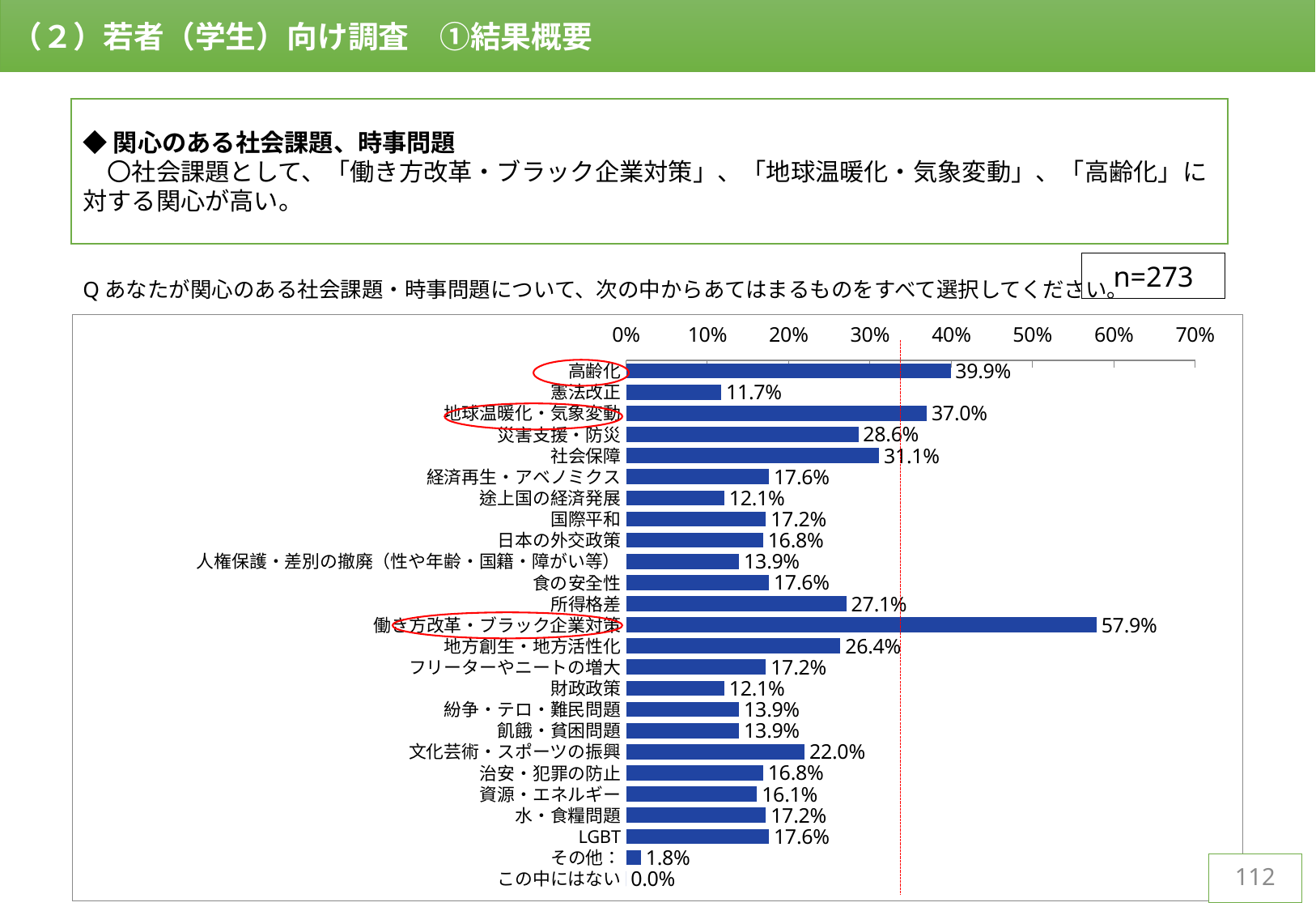
Is the value for 文化芸術・スポーツの振興 greater or less than 20%? greater What is the difference between the values for 働き方改革・ブラック企業対策 and 高齢化? 18.0% What is the value for 高齢化? 39.9% Which category has the lowest value? この中にはない Which is larger, the value for 社会保障 or the value for 災害支援・防災? 社会保障 What is the sample size (n) shown for the survey? n=273 What is the value for 地球温暖化・気象変動? 37.0% Which category has the highest value? 働き方改革・ブラック企業対策 What is the value for 所得格差? 27.1% What is the value for 働き方改革・ブラック企業対策? 57.9% How many categories are shown in the chart? 25 What kind of chart is shown on the slide? bar chart